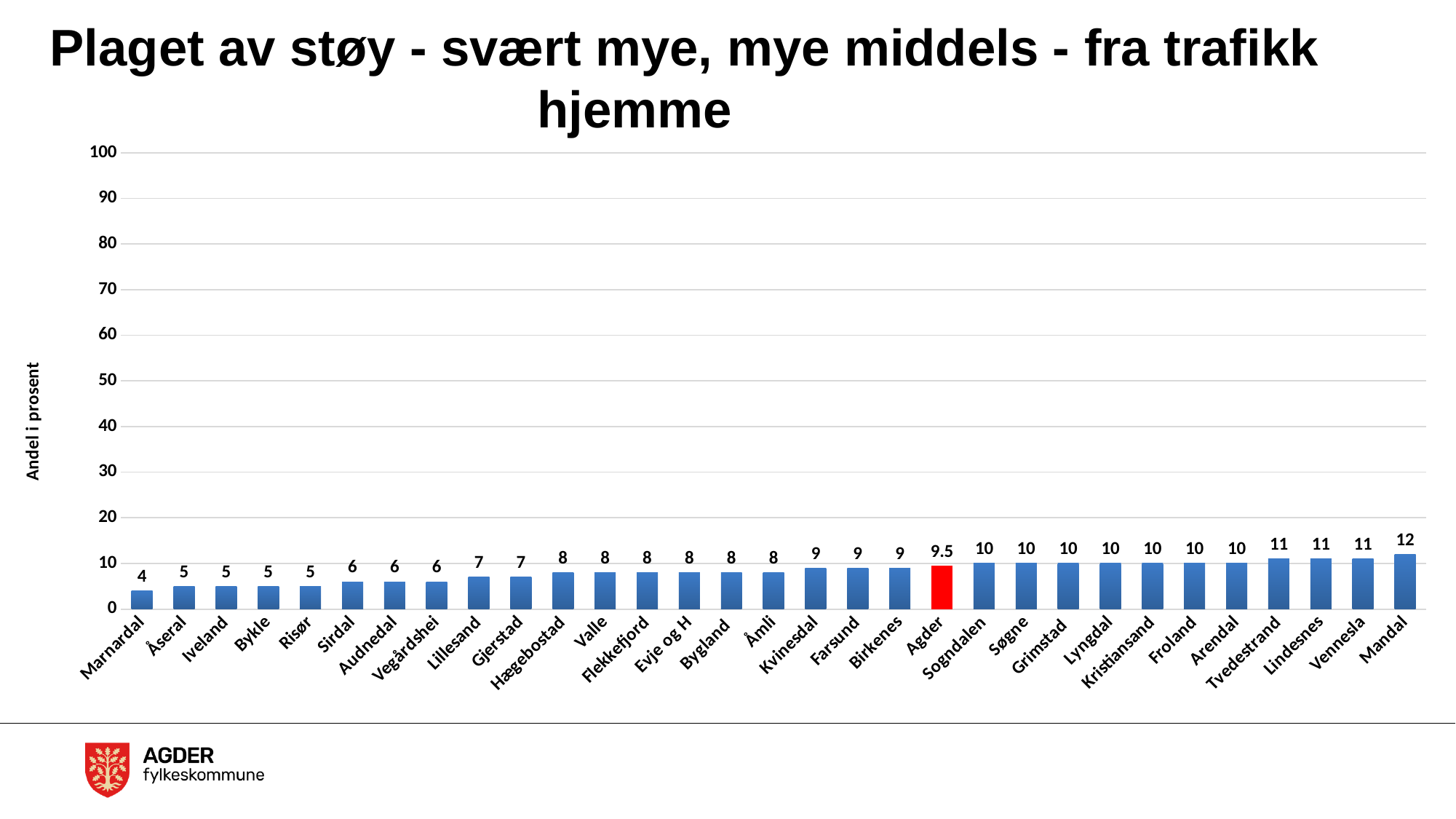
Do the values rise or fall from left to right along the x axis? rise Which category has the highest value? Mandal Which is larger, the value for Sirdal or the value for Tvedestrand? Tvedestrand How many categories are shown on the x axis? 31 Which category has the lowest value? Marnardal What is the value for Agder? 9.5 Is the value for Vennesla greater or less than 20? less What is the value for Marnardal? 4 Which bar is coloured red? Agder What is the difference between the values for Mandal and Marnardal? 8 What kind of chart is shown on the slide? bar chart What is the value for Kristiansand? 10